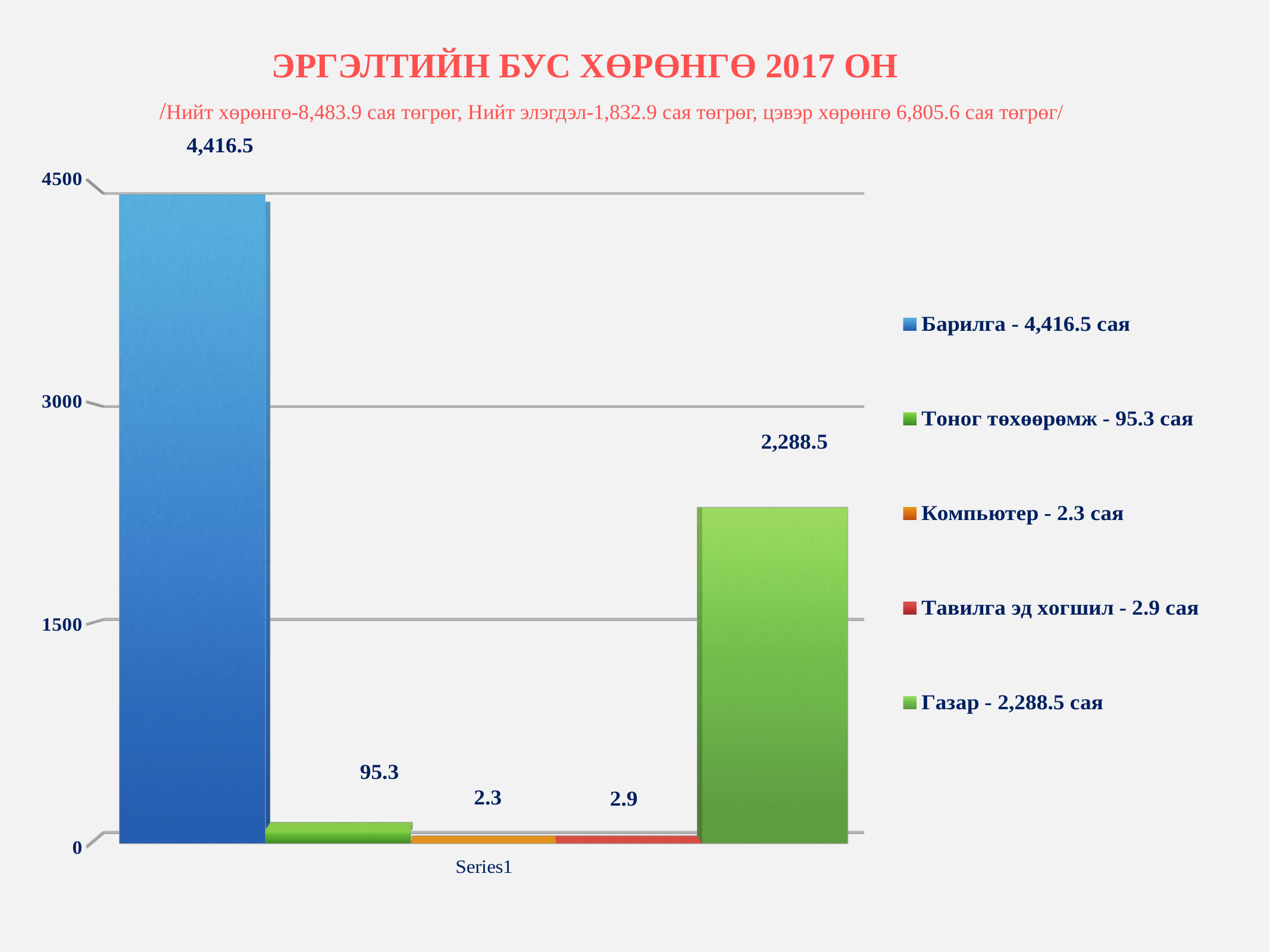
What is the value shown for Барилга? 4,416.5 What is the title of the chart? ЭРГЭЛТИЙН БУС ХӨРӨНГӨ 2017 ОН What is the difference between the values for Барилга and Газар? 2,128.0 Is the value for Газар greater or less than 1500? greater What is the value shown for Газар? 2,288.5 What is the value shown for Компьютер? 2.3 Which series has the highest value? Барилга What is the value shown for Тоног төхөөрөмж? 95.3 What kind of chart is shown on the slide? bar chart How many series does the legend list? 5 Which series has the lowest value? Компьютер Which is larger, the value for Тавилга эд хогшил or the value for Компьютер? Тавилга эд хогшил